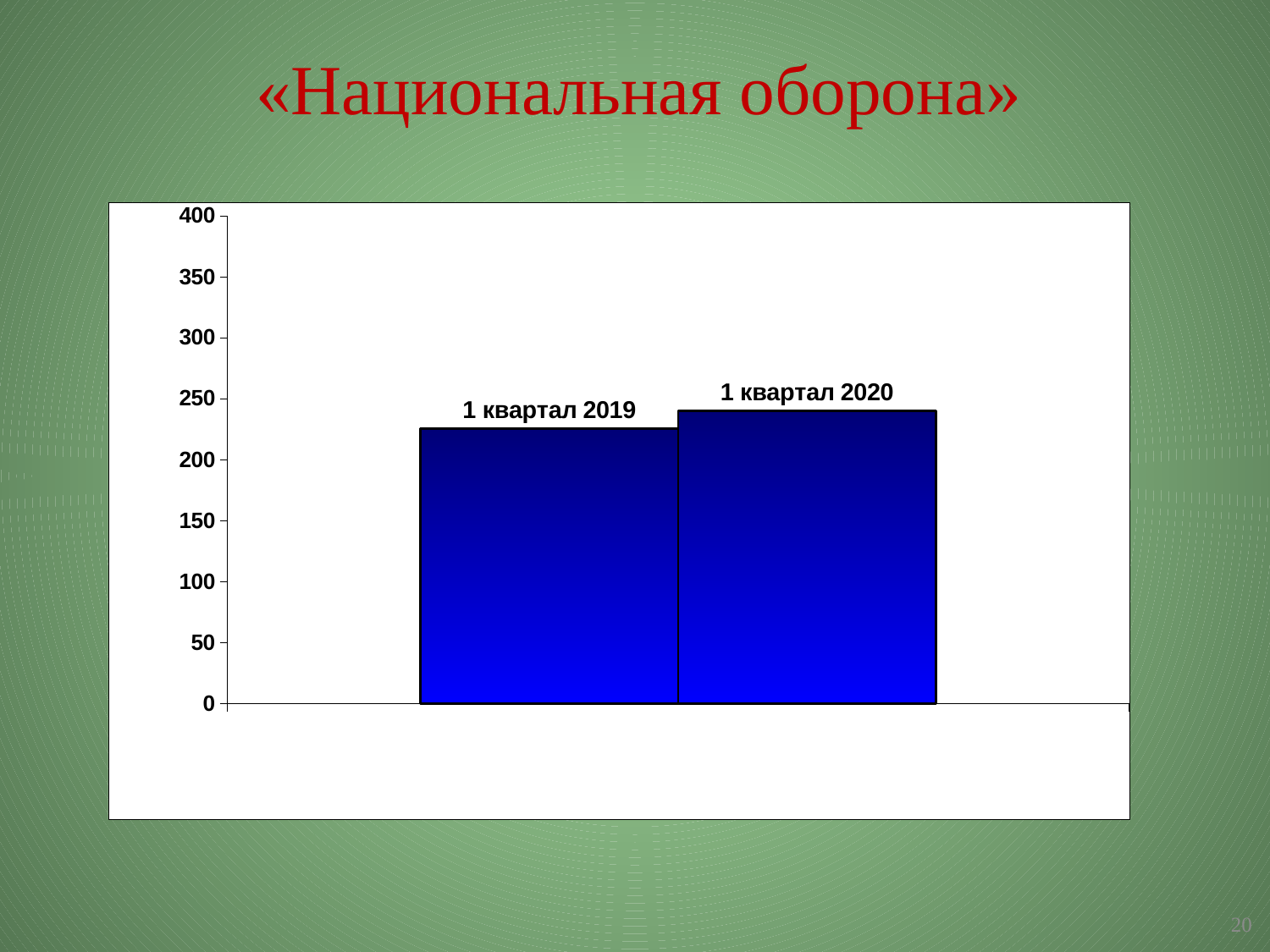
Which bar is taller, 1 квартал 2019 or 1 квартал 2020? 1 квартал 2020 What kind of chart is shown on the slide? bar chart Is the value for 1 квартал 2020 greater or less than 200? greater Which category has the highest value in the chart? 1 квартал 2020 Is the value for 1 квартал 2020 greater or less than 250? less Is the value for 1 квартал 2019 greater or less than 200? greater How many bars are plotted in the chart? 2 What is the maximum value shown on the vertical axis of the chart? 400 Which category has the lowest value in the chart? 1 квартал 2019 Do the values rise or fall from 1 квартал 2019 to 1 квартал 2020? rise What is the title of the slide containing the chart? «Национальная оборона»